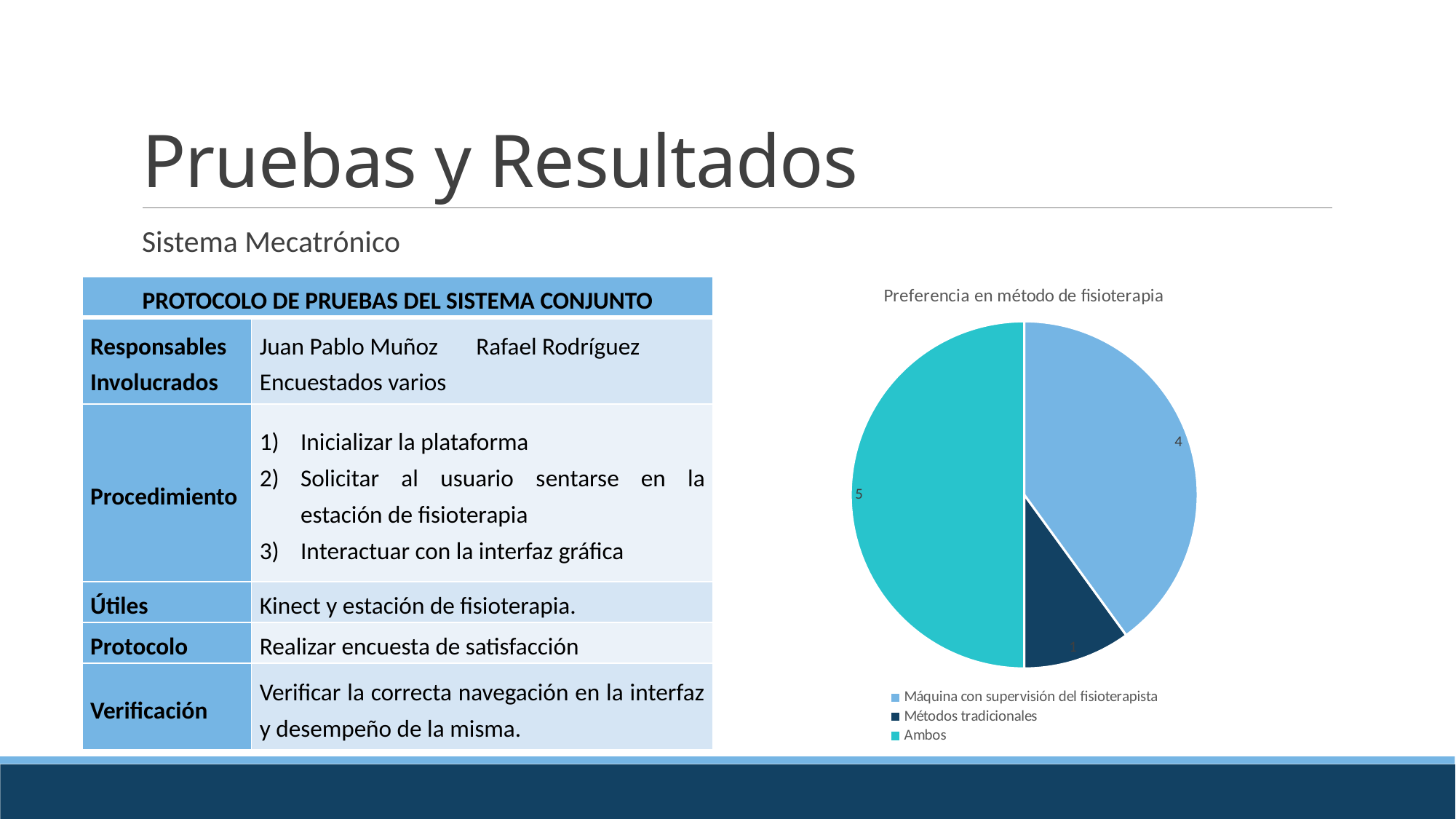
Which category has the smallest slice of the pie? Métodos tradicionales What is the value for 'Ambos'? 5 What kind of chart is shown on the slide? pie chart Which category has the largest slice of the pie? Ambos Which is larger, the value for 'Ambos' or the value for 'Máquina con supervisión del fisioterapista'? Ambos What is the title of the chart? Preferencia en método de fisioterapia What share of the pie does 'Ambos' represent? 50% What is the value for 'Métodos tradicionales'? 1 What is the value for 'Máquina con supervisión del fisioterapista'? 4 How many categories does the legend of the pie chart list? 3 What is the difference between the value for 'Ambos' and the value for 'Métodos tradicionales'? 4 Which colour is used for the 'Métodos tradicionales' slice? dark navy blue